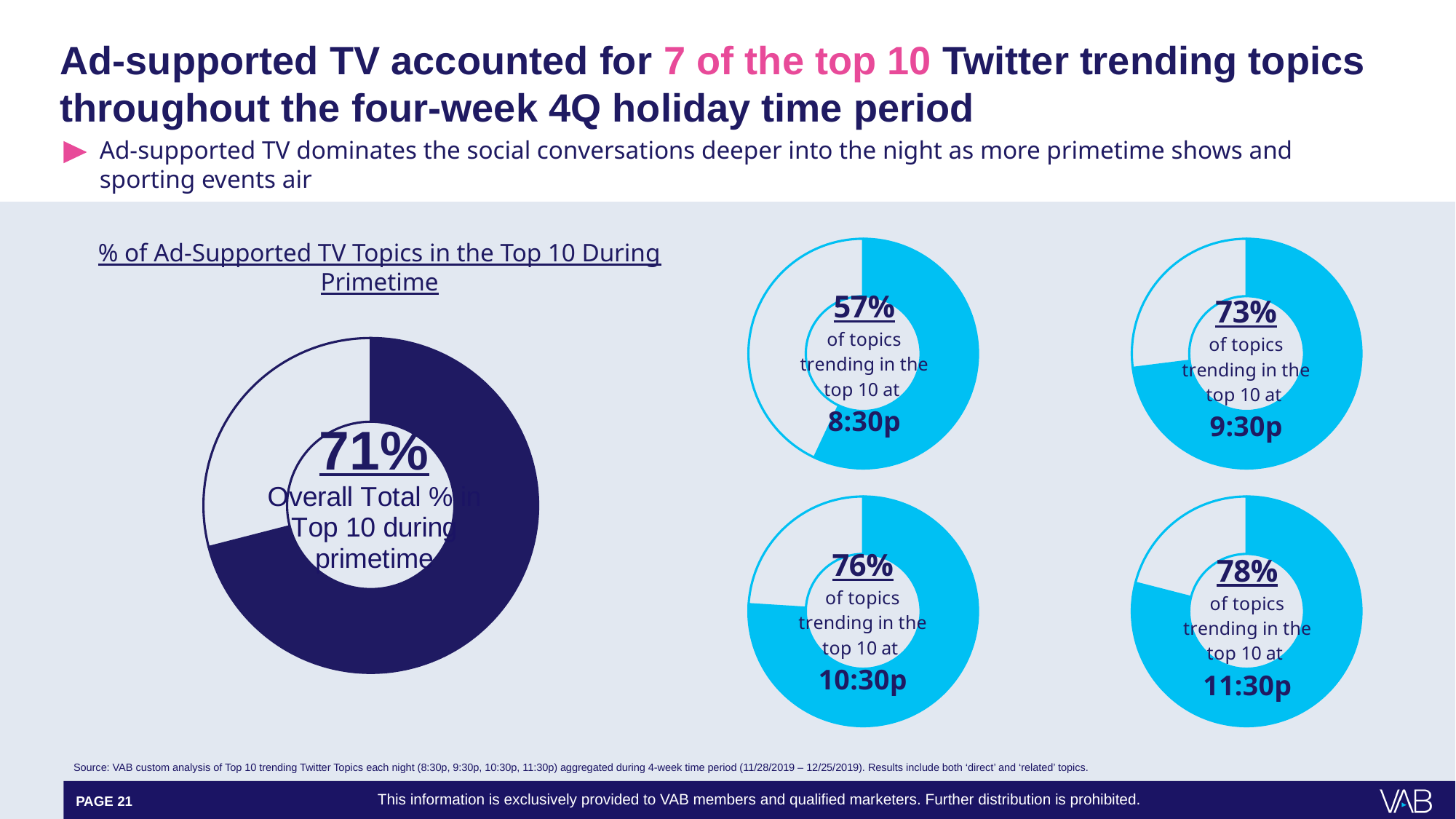
In the large donut chart on the left, what is the overall total % of ad-supported TV topics in the top 10 during primetime? 71% In the small donut chart for 9:30p, what percentage of topics trending in the top 10 were ad-supported TV? 73% How many small time-slot donut charts are shown on the right side of the slide? 4 Among the four time-slot donut charts on the right, which time slot has the highest percentage? 11:30p Among the four time-slot donut charts on the right, which time slot has the lowest percentage? 8:30p In the small donut chart for 8:30p, what percentage of topics trending in the top 10 were ad-supported TV? 57% In the small donut chart for 11:30p, what percentage is shown? 78% What is the title of the large chart on the left? % of Ad-Supported TV Topics in the Top 10 During Primetime In the small donut chart for 10:30p, what percentage is shown? 76% Which is larger: the percentage in the 9:30p donut chart or the percentage in the 10:30p donut chart? 10:30p Across the four time-slot donut charts on the right, do the percentages rise or fall as the time gets later? rise What is the difference in percentage points between the 11:30p donut chart and the 8:30p donut chart? 21